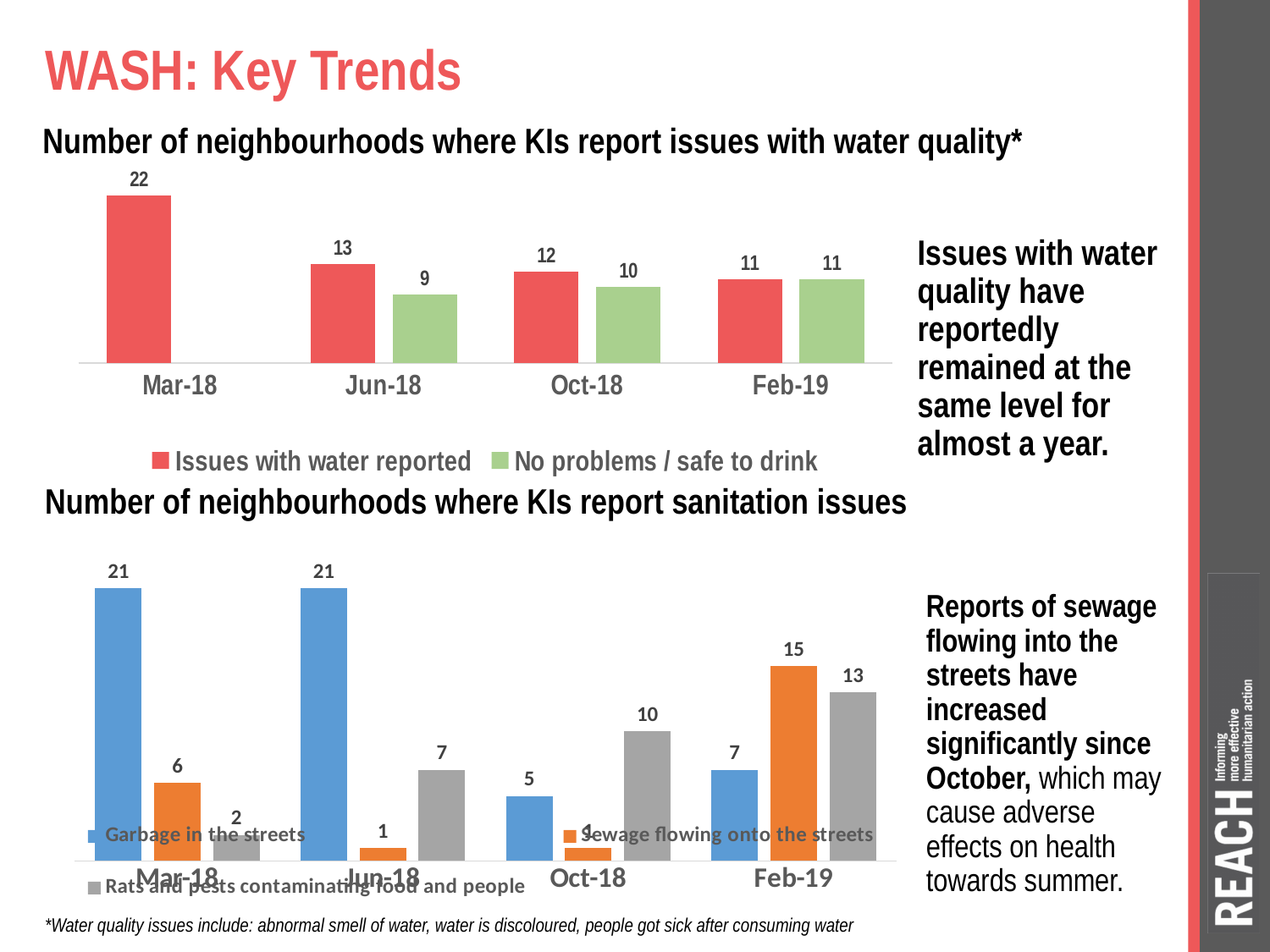
In the water quality chart, what is the value for 'No problems / safe to drink' in Oct-18? 10 What type of chart is the sanitation issues chart? bar chart In the sanitation issues chart, what is the value for 'Sewage flowing onto the streets' in Feb-19? 15 In the sanitation issues chart, what is the value for 'Rats and pests contaminating food and people' in Oct-18? 10 In the water quality chart, does the 'Issues with water reported' series rise or fall from Mar-18 to Feb-19? fall In the water quality chart, what is the value for 'Issues with water reported' in Mar-18? 22 In the sanitation issues chart, which month has the lowest value for 'Garbage in the streets'? Oct-18 In the sanitation issues chart, which is larger in Feb-19: 'Garbage in the streets' or 'Sewage flowing onto the streets'? Sewage flowing onto the streets In the water quality chart, what is the difference between 'Issues with water reported' and 'No problems / safe to drink' in Jun-18? 4 How many series does the legend of the water quality chart list? 2 In the sanitation issues chart, what is the difference between 'Garbage in the streets' in Jun-18 and in Oct-18? 16 In the water quality chart, which month has the highest value for 'Issues with water reported'? Mar-18